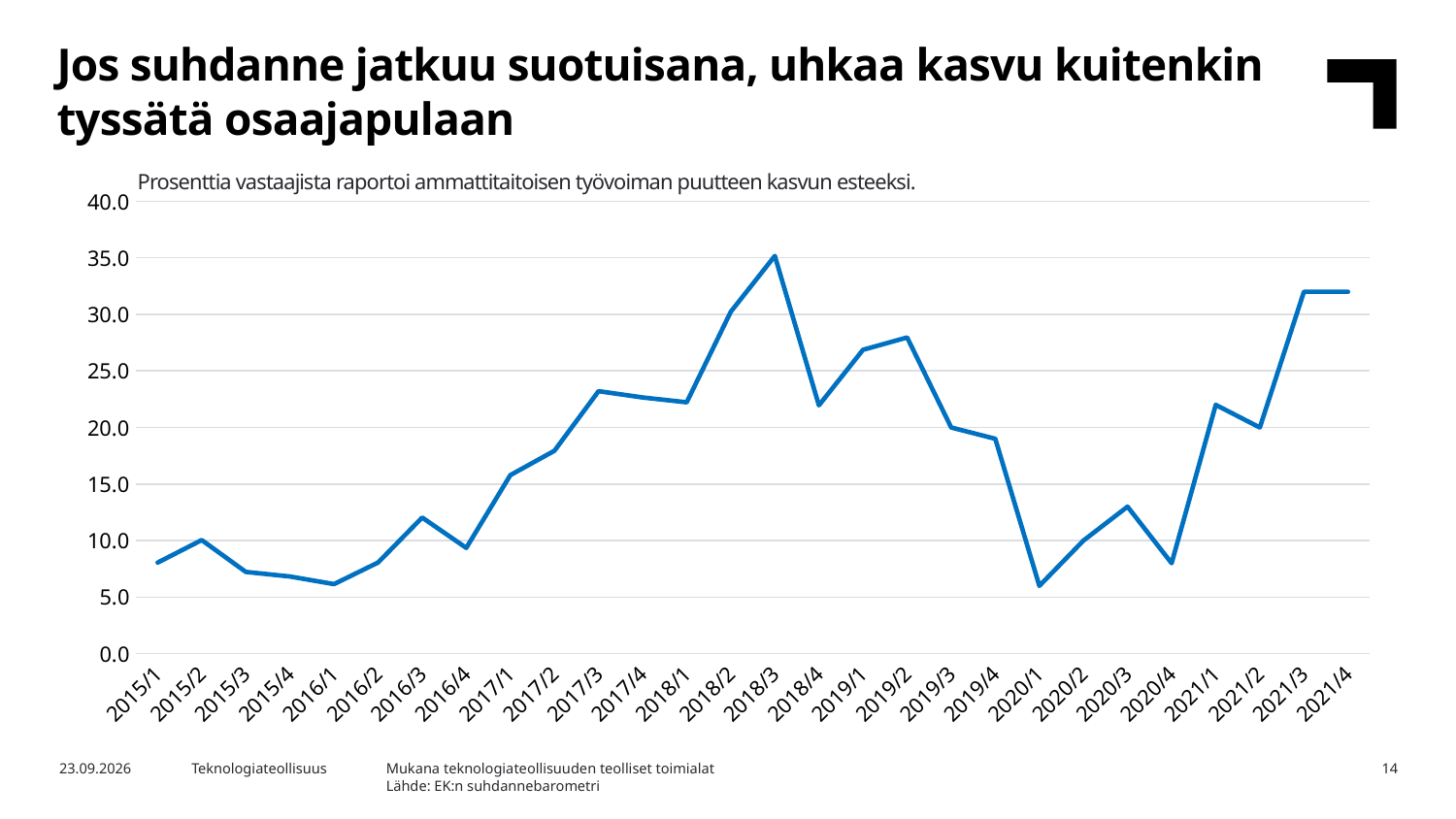
What kind of chart is shown on the slide? line chart Is the value for 2015/1 greater or less than 10.0? less Is the value for 2021/3 greater or less than 30.0? greater In which quarter does the line reach its highest value? 2018/3 Which is larger, the value for 2020/1 or the value for 2020/3? 2020/3 Is the value for 2020/1 greater or less than 10.0? less Does the line rise or fall between 2019/2 and 2020/1? fall How many quarters (x-axis categories) are plotted on the chart? 28 What does the text above the chart say the values represent? Prosenttia vastaajista raportoi ammattitaitoisen työvoiman puutteen kasvun esteeksi. Which is larger, the value for 2018/3 or the value for 2021/3? 2018/3